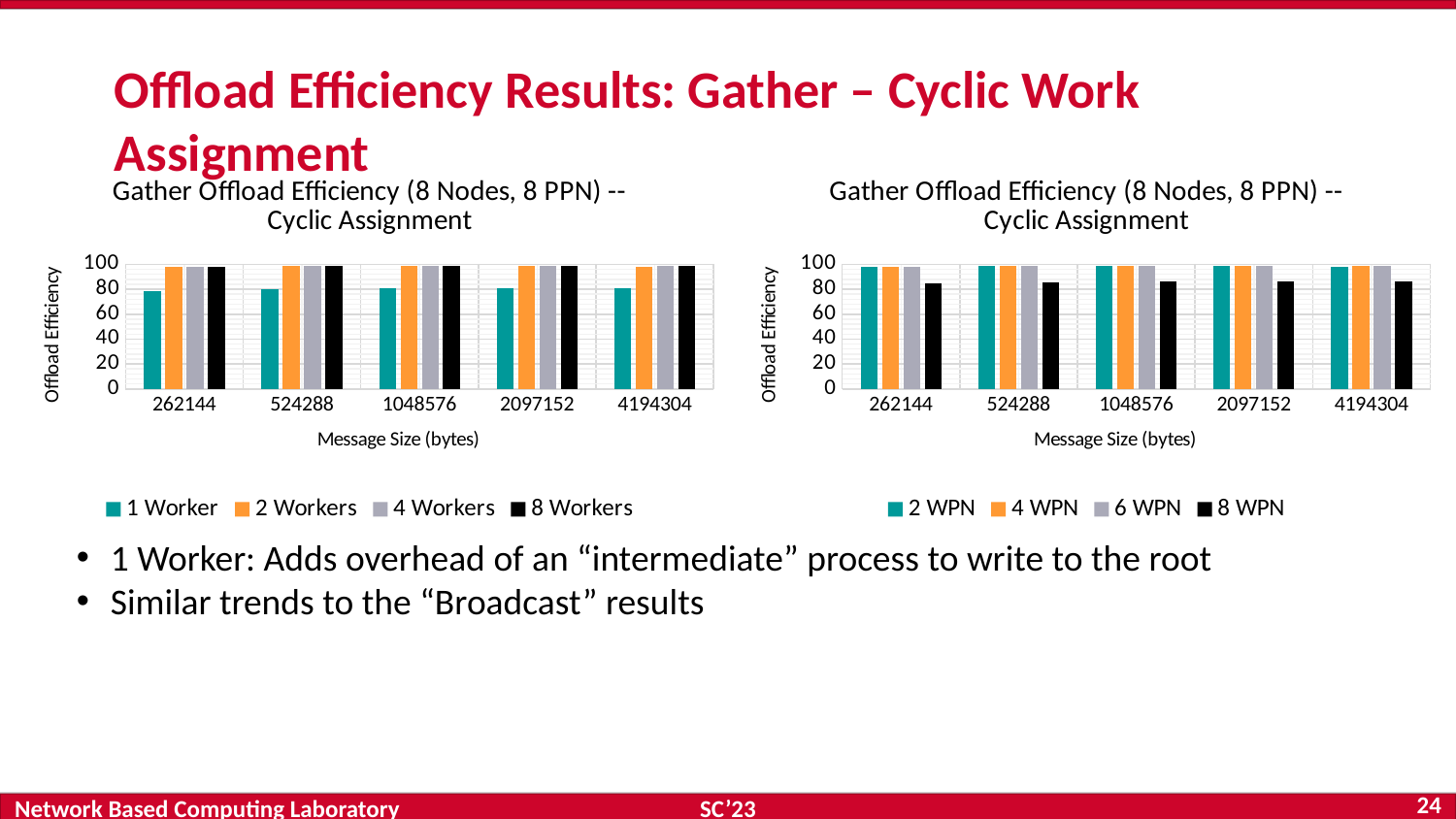
What is the y-axis title of the left chart? Offload Efficiency What kind of chart is the left chart on the slide? bar chart In the right chart, is the value for 8 WPN at message size 262144 greater or less than 60? greater In the left chart, is the value for 1 Worker at message size 1048576 greater or less than 60? greater In the right chart, which series has the lowest value at message size 2097152? 8 WPN In the left chart, is the value for 1 Worker at message size 262144 greater or less than 100? less What is the x-axis title of the right chart? Message Size (bytes) How many message-size categories does the left chart show on its x axis? 5 In the left chart, which series has the lowest value at message size 524288? 1 Worker How many series does the legend of the left chart list? 4 In the right chart, which is larger at message size 4194304: the value for 2 WPN or the value for 8 WPN? 2 WPN How many series does the legend of the right chart list? 4